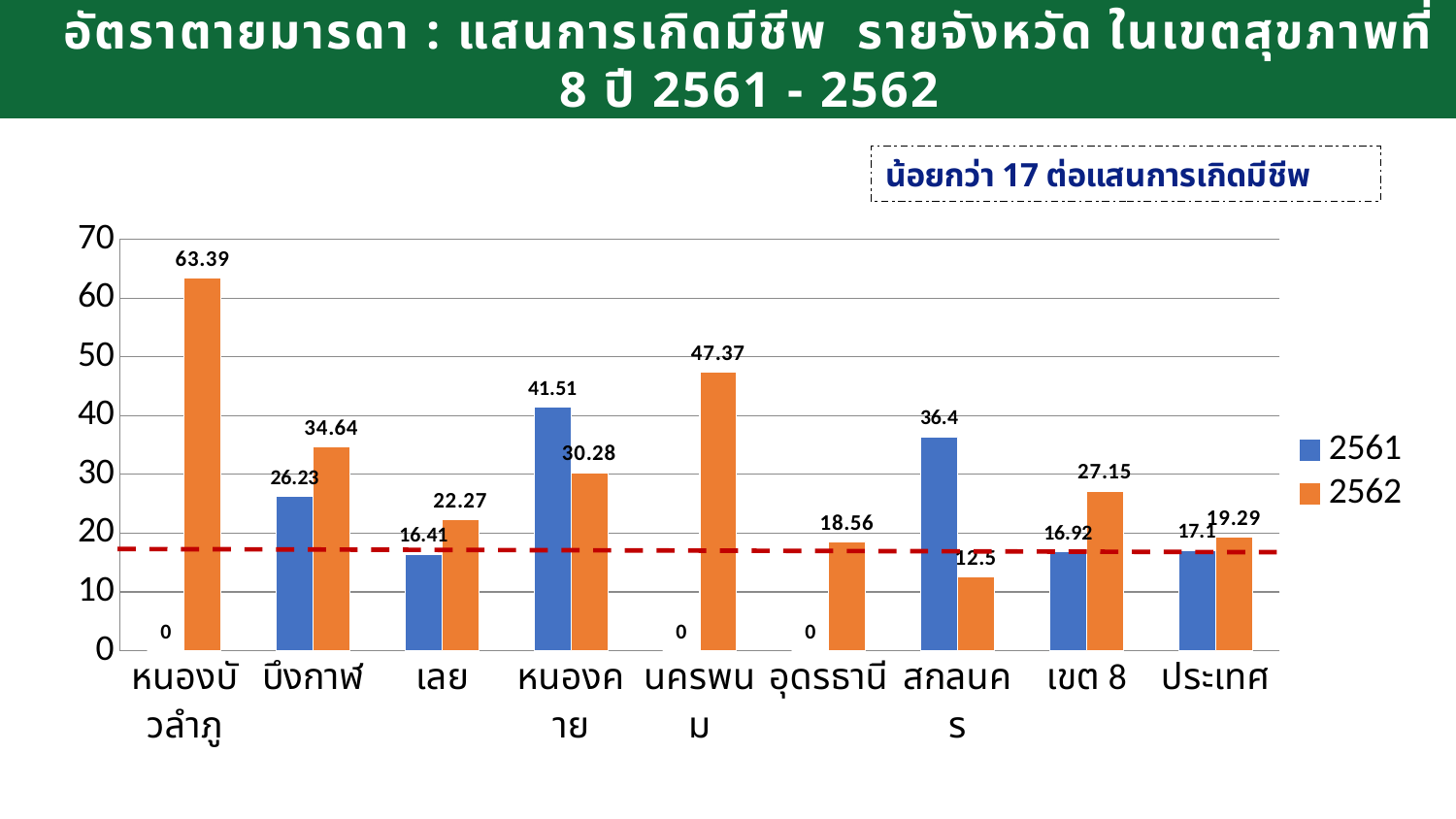
What is the 2562 value for หนองบัวลำภู? 63.39 Which province has the highest 2562 value? หนองบัวลำภู For สกลนคร, which year has the larger value, 2561 or 2562? 2561 What kind of chart is shown on the slide? bar chart What is the 2561 value for ประเทศ? 17.1 Which category has the lowest 2562 value? สกลนคร How many series does the legend list? 2 What is the 2562 value for สกลนคร? 12.5 How many categories are shown on the x axis? 9 Which colour represents the 2562 series in the legend? orange What is the difference between the 2562 and 2561 values for บึงกาฬ? 8.41 What is the 2561 value for หนองคาย? 41.51